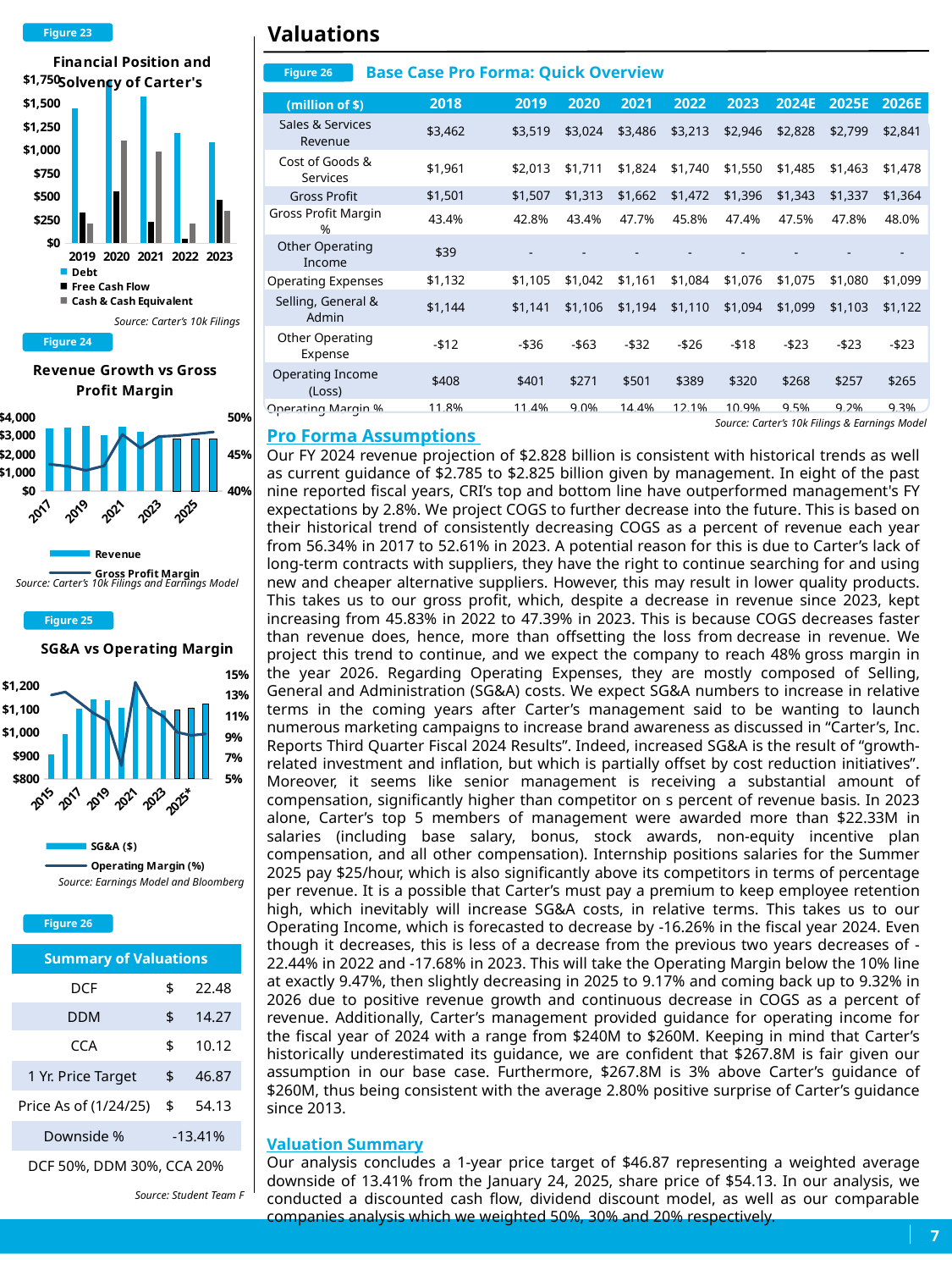
In the 'Financial Position and Solvency of Carter's' chart, is the Debt value for 2019 greater or less than $1,250? greater In the 'SG&A vs Operating Margin' chart (Figure 25), which year has the lowest Operating Margin (%)? 2020 How many series does the legend of the 'SG&A vs Operating Margin' chart list? 2 In the 'Financial Position and Solvency of Carter's' chart, which year has the highest Debt? 2020 In the 'Financial Position and Solvency of Carter's' chart, which year has the lowest Free Cash Flow? 2022 How many years are shown on the x axis of the 'Revenue Growth vs Gross Profit Margin' chart (Figure 24)? 10 How many series does the legend of the 'Financial Position and Solvency of Carter's' chart list? 3 In the 'Financial Position and Solvency of Carter's' chart, is the Free Cash Flow value for 2020 greater or less than $750? less In the 'Revenue Growth vs Gross Profit Margin' chart, is the Revenue value for 2025 greater or less than $3,000? less In the 'Financial Position and Solvency of Carter's' chart, which is larger in 2021: Debt or Cash & Cash Equivalent? Debt What kind of chart is the 'Financial Position and Solvency of Carter's' chart (Figure 23)? bar chart